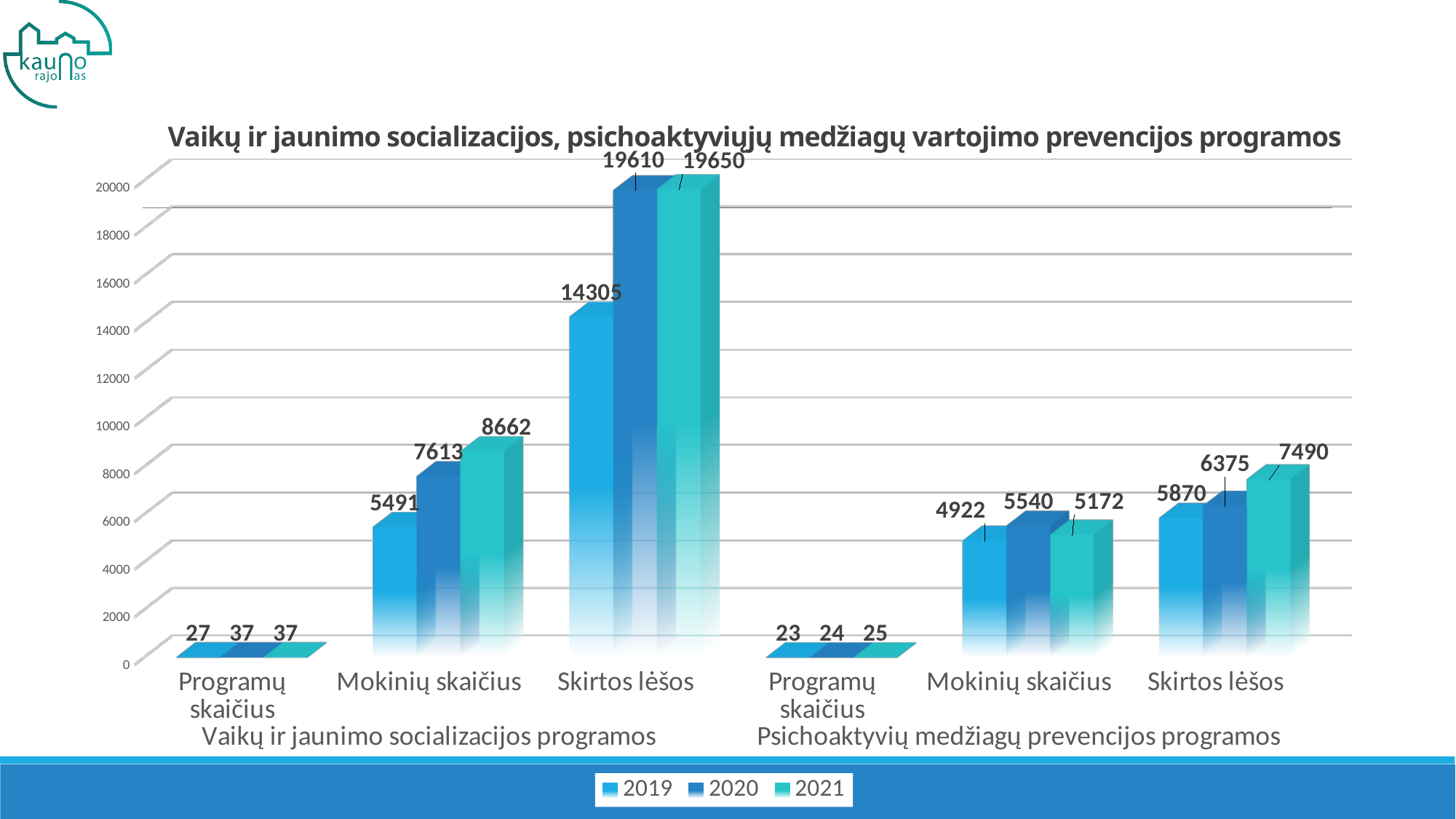
What is the 2021 value for Programų skaičius under Psichoaktyvių medžiagų prevencijos programos? 25 What kind of chart is shown on the slide? bar chart What is the title of the chart? Vaikų ir jaunimo socializacijos, psichoaktyviųjų medžiagų vartojimo prevencijos programos What is the difference between the 2021 and 2019 values for Skirtos lėšos under Vaikų ir jaunimo socializacijos programos? 5345 What is the 2021 value for Mokinių skaičius under Vaikų ir jaunimo socializacijos programos? 8662 Which year has the highest value for Skirtos lėšos under Psichoaktyvių medžiagų prevencijos programos? 2021 Do the values for Skirtos lėšos under Psichoaktyvių medžiagų prevencijos programos rise or fall from 2019 to 2021? rise What is the 2019 value for Skirtos lėšos under Vaikų ir jaunimo socializacijos programos? 14305 How many series does the legend list? 3 Which year has the lowest value for Mokinių skaičius under Vaikų ir jaunimo socializacijos programos? 2019 Which is larger: the 2020 value for Mokinių skaičius under Psichoaktyvių medžiagų prevencijos programos or the 2021 value for the same category? 2020 What is the 2020 value for Mokinių skaičius under Psichoaktyvių medžiagų prevencijos programos? 5540